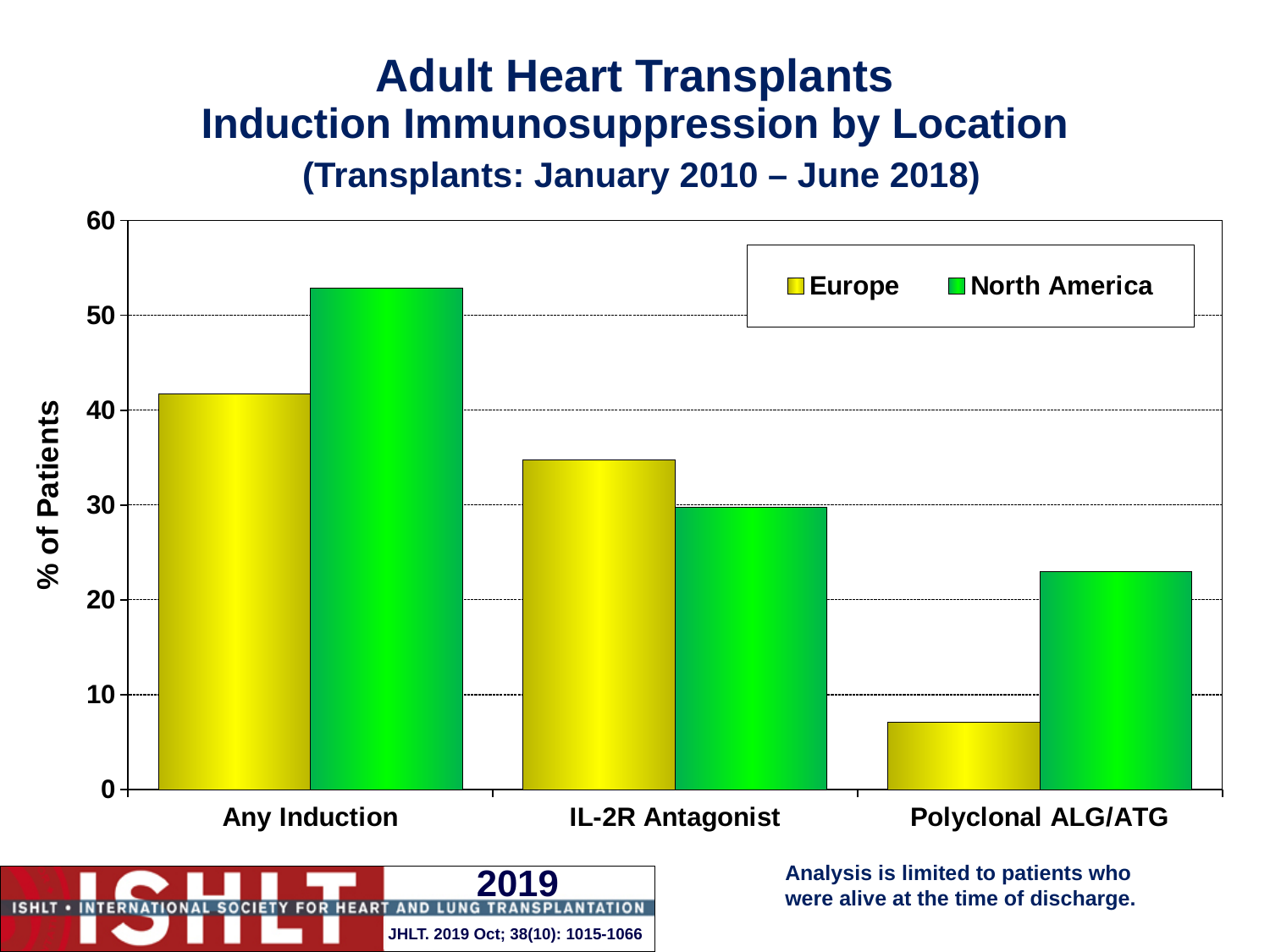
Is the value for North America in Any Induction greater or less than 50? greater Which series has the higher value for Polyclonal ALG/ATG, Europe or North America? North America Which series has the higher value for IL-2R Antagonist, Europe or North America? Europe Is the value for Europe in Polyclonal ALG/ATG greater or less than 10? less Which category has the highest value for North America? Any Induction Which series has the higher value for Any Induction, Europe or North America? North America How many categories are shown on the x axis? 3 What is the label of the y axis? % of Patients How many series does the legend list? 2 Which category has the lowest value for Europe? Polyclonal ALG/ATG What kind of chart is shown on the slide? bar chart Is the value for Europe in IL-2R Antagonist greater or less than 30? greater